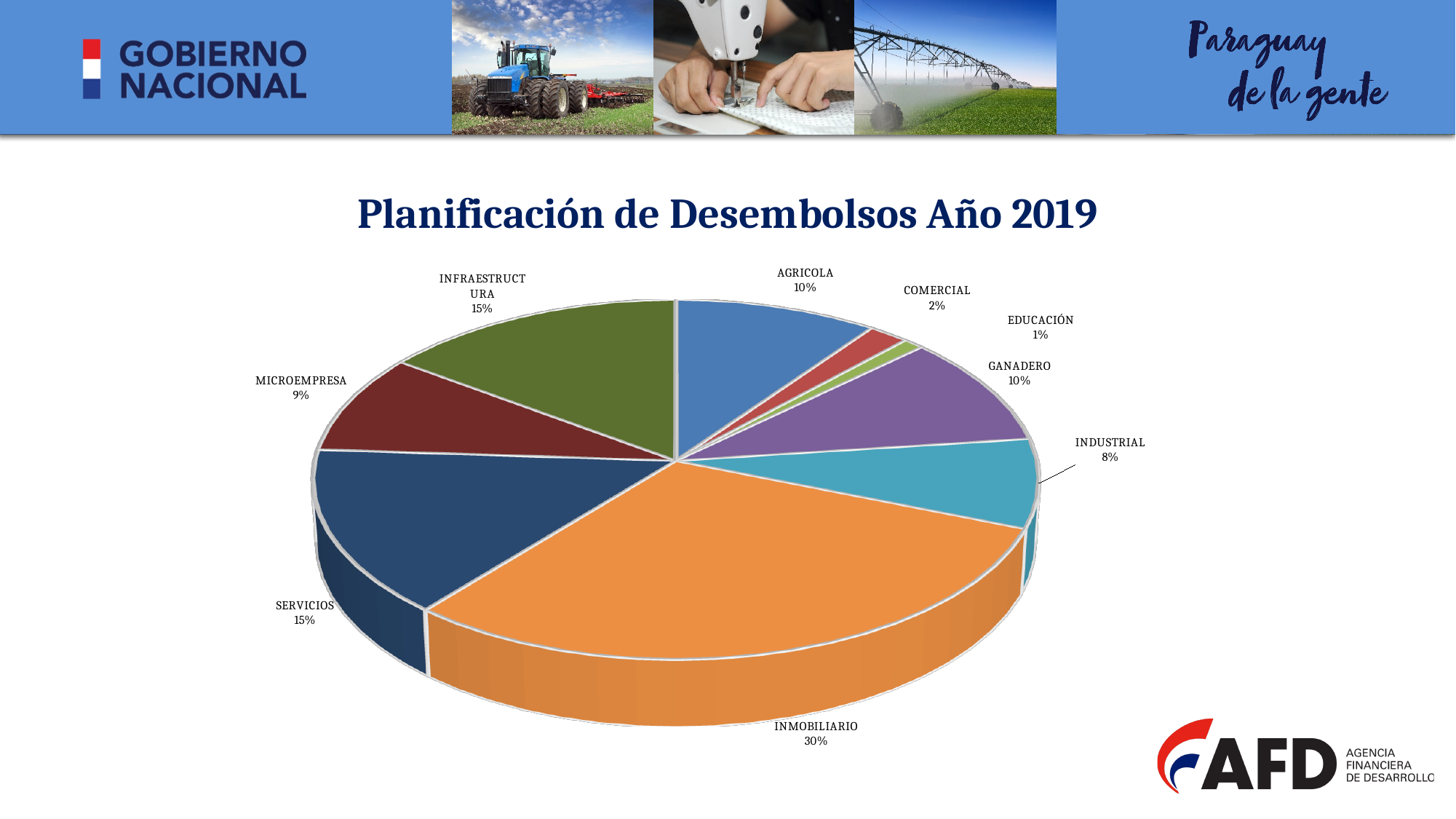
How many categories are shown in the pie chart? 9 What is the value shown for AGRICOLA? 10% What kind of chart is shown on the slide? Pie chart Which is larger, the share for MICROEMPRESA or the share for INDUSTRIAL? MICROEMPRESA What is the value shown for COMERCIAL? 2% What is the title of the chart? Planificación de Desembolsos Año 2019 What is the combined share of INFRAESTRUCTURA and SERVICIOS? 30% What share of the pie does INMOBILIARIO represent? 30% What is the value shown for INDUSTRIAL? 8% Which category has the smallest slice of the pie? EDUCACIÓN Which category has the largest slice of the pie? INMOBILIARIO What is the difference between the shares of INMOBILIARIO and SERVICIOS? 15%